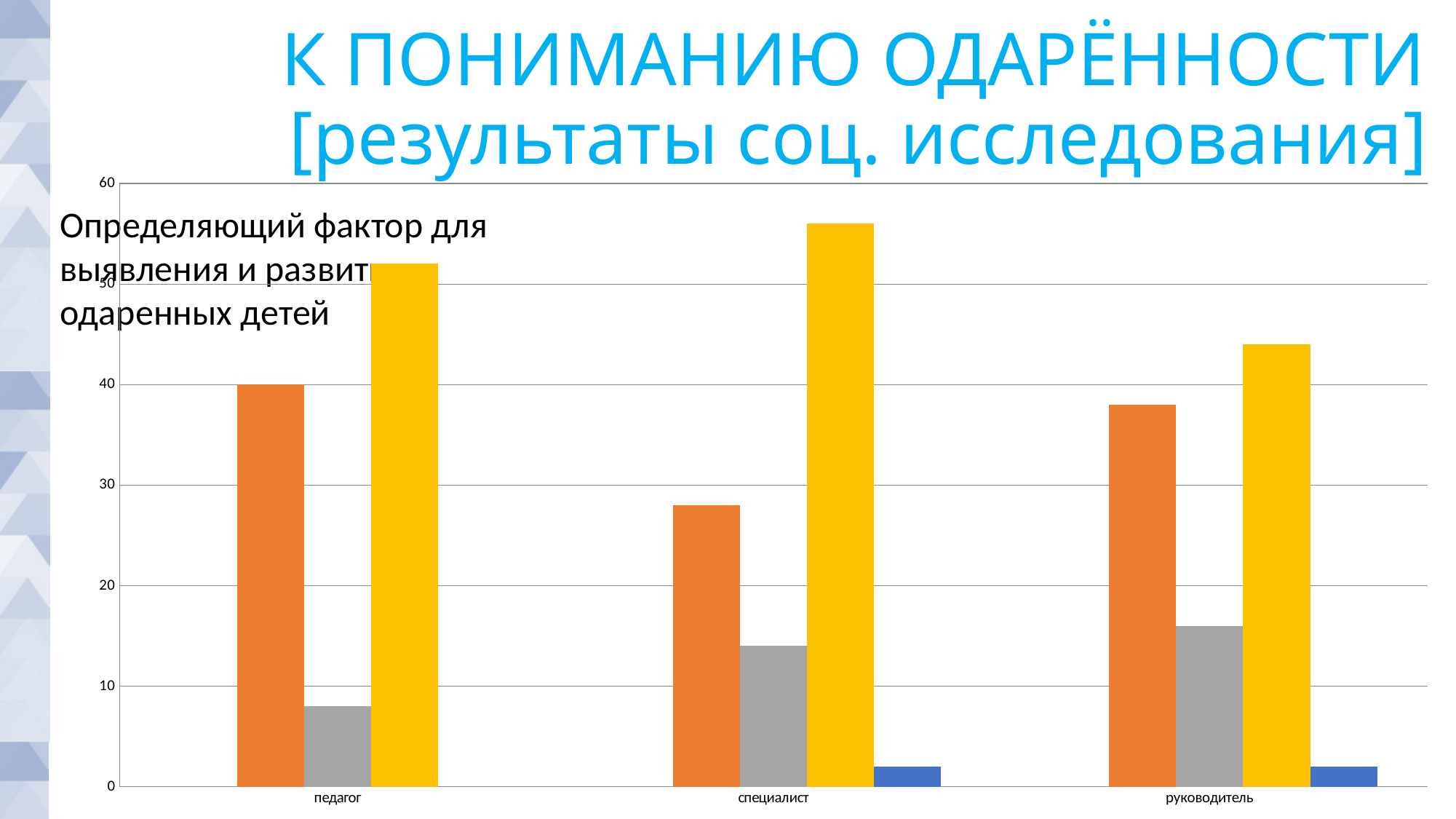
Is the value of the gray bar for педагог greater or less than 10? less What kind of chart is shown on the slide? bar chart How many categories are shown on the x axis of the chart? 3 Is the value of the yellow bar for руководитель greater or less than 40? greater Is the value of the yellow bar for специалист greater or less than 50? greater What is the value of the orange bar for педагог? 40 Which category has the shortest gray bar? педагог Which is larger: the yellow bar for педагог or the yellow bar for руководитель? the yellow bar for педагог What is the highest value shown on the vertical axis of the chart? 60 For специалист, which is larger: the orange bar or the gray bar? the orange bar Which category has the tallest yellow bar? специалист